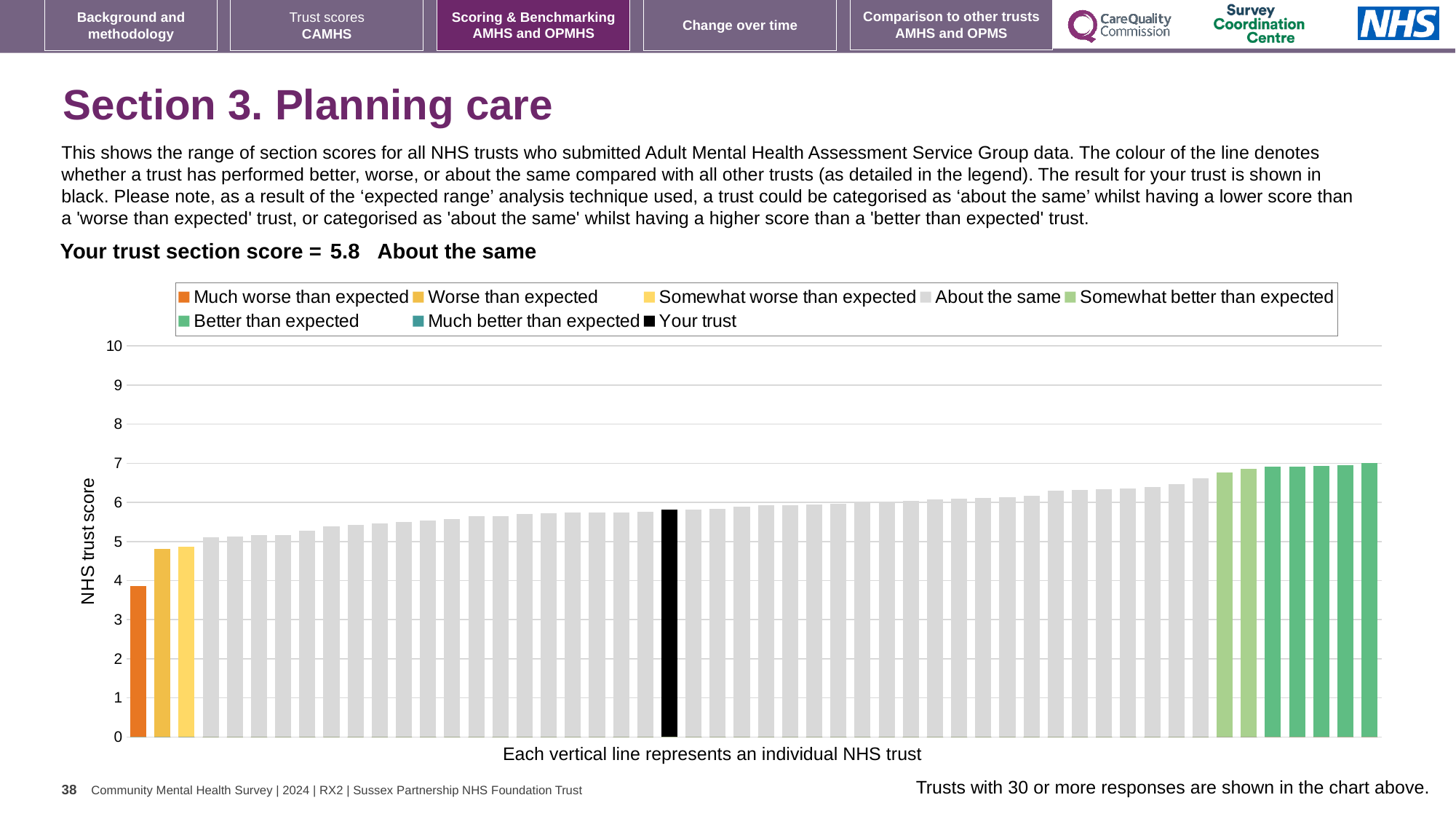
Is the value of the leftmost (orange) bar greater or less than 3? greater How many entries does the chart legend list? 8 Is the value of the rightmost bar greater or less than 6? greater How many bars are coloured orange (Much worse than expected)? 1 What is your trust's section score for Planning care? 5.8 What is the title of the vertical axis? NHS trust score Is the value of the black 'Your trust' bar greater or less than 6? less Do the bar values rise or fall from left to right across the chart? rise Which is higher, the leftmost bar or the rightmost bar? the rightmost bar What kind of chart is shown on the slide? bar chart How many bars are coloured yellow (Worse than expected)? 1